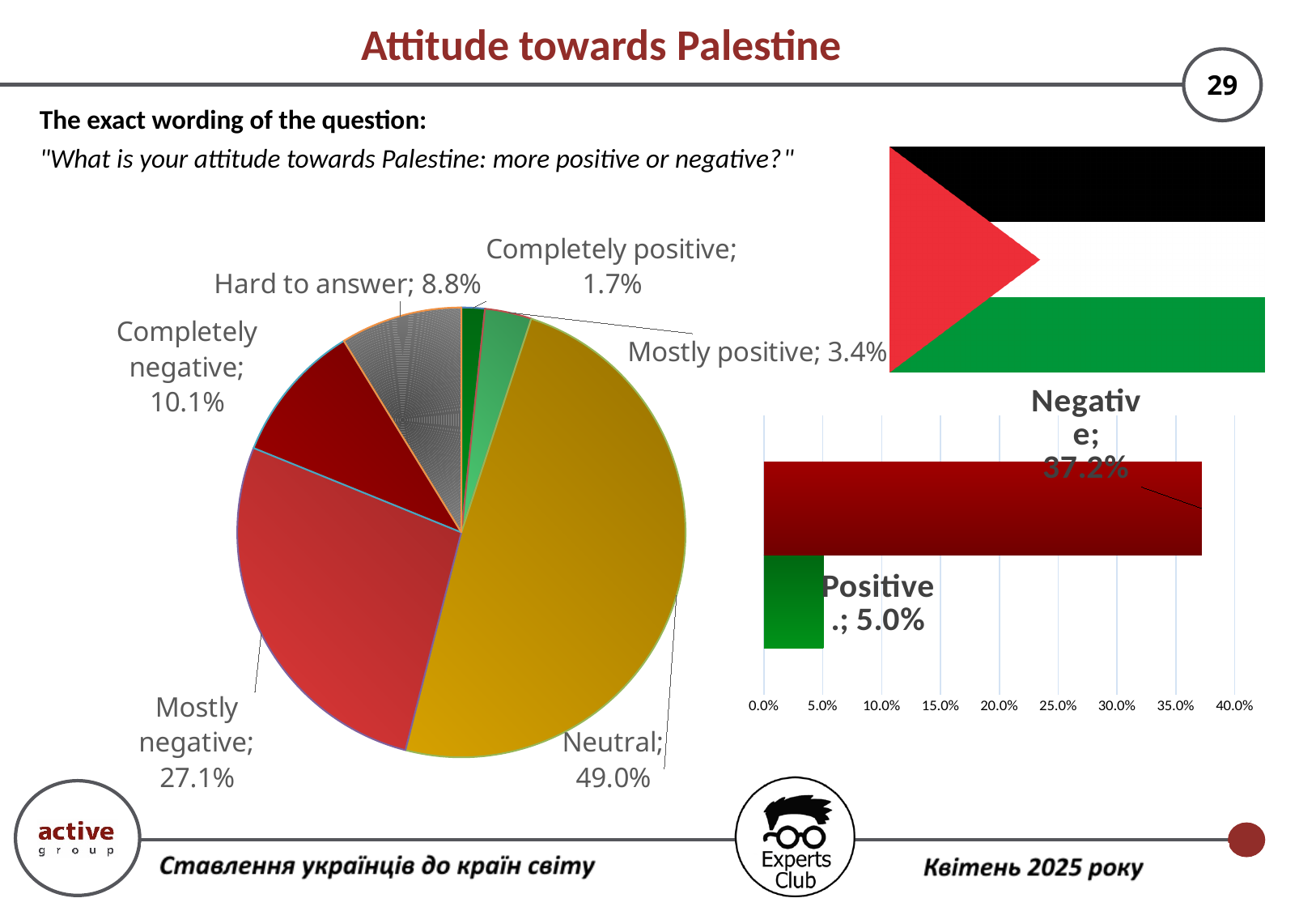
In the pie chart, which category has the largest share? Neutral In the pie chart, what is the value for "Hard to answer"? 8.8% In the pie chart, which category has the smallest share? Completely positive In the pie chart, which is larger: "Mostly positive" or "Hard to answer"? Hard to answer In the bar chart on the right, what is the value for "Negative"? 37.2% In the pie chart, what share of respondents answered "Neutral"? 49.0% In the bar chart on the right, what is the difference between "Negative" and "Positive"? 32.2% In the pie chart, what is the difference between "Completely negative" and "Completely positive"? 8.4% What is the title of the slide? Attitude towards Palestine What type of chart is the chart on the right side of the slide? Bar chart In the pie chart, what is the value for "Mostly negative"? 27.1% How many categories does the pie chart show? 6